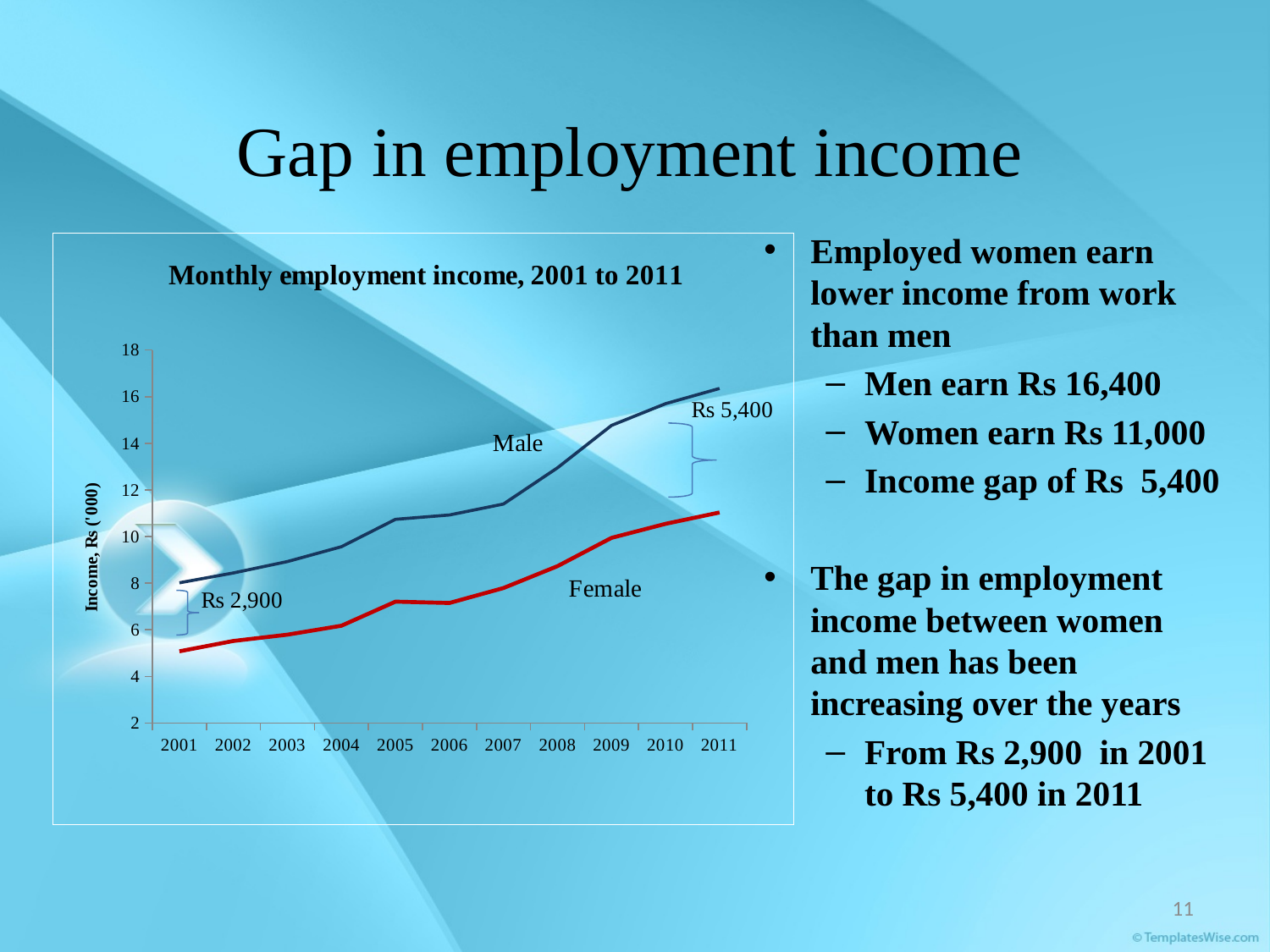
What is the income gap between Male and Female shown on the chart for 2011? Rs 5,400 In which year is the Female series at its lowest? 2001 How many years are shown along the x axis of the chart? 11 Which series is higher in 2011, Male or Female? Male What kind of chart is shown on the slide? line chart What is the income gap between Male and Female shown on the chart for 2001? Rs 2,900 Does the Male line rise or fall from 2001 to 2011? rise Is the value for Male in 2001 greater or less than 10? less How many series are plotted on the chart? 2 Is the value for Male in 2011 greater or less than 14? greater Is the value for Female in 2006 greater or less than 8? less What is the title of the chart? Monthly employment income, 2001 to 2011